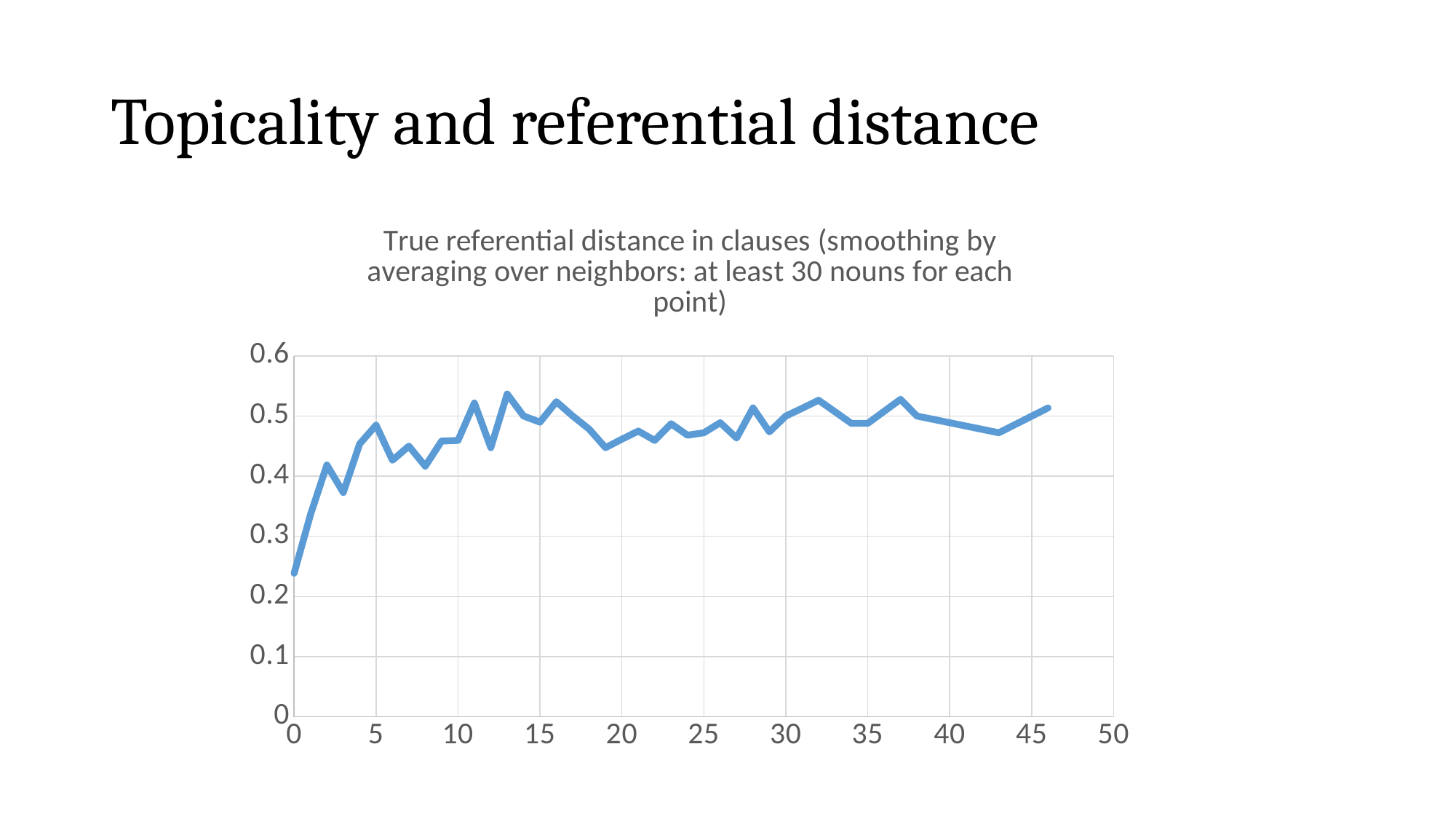
Is the value at x = 43 greater or less than 0.5? less Which is larger, the value at x = 0 or the value at x = 5? x = 5 Is the value at x = 0 greater or less than 0.3? less What kind of chart is shown on the slide? line chart Does the line rise or fall between x = 0 and x = 5? rise Is the value at x = 2 greater or less than 0.4? greater What is the title of the chart? True referential distance in clauses (smoothing by averaging over neighbors: at least 30 nouns for each point) At which x value does the line reach its lowest point? 0 What is the highest value labelled on the vertical axis of the chart? 0.6